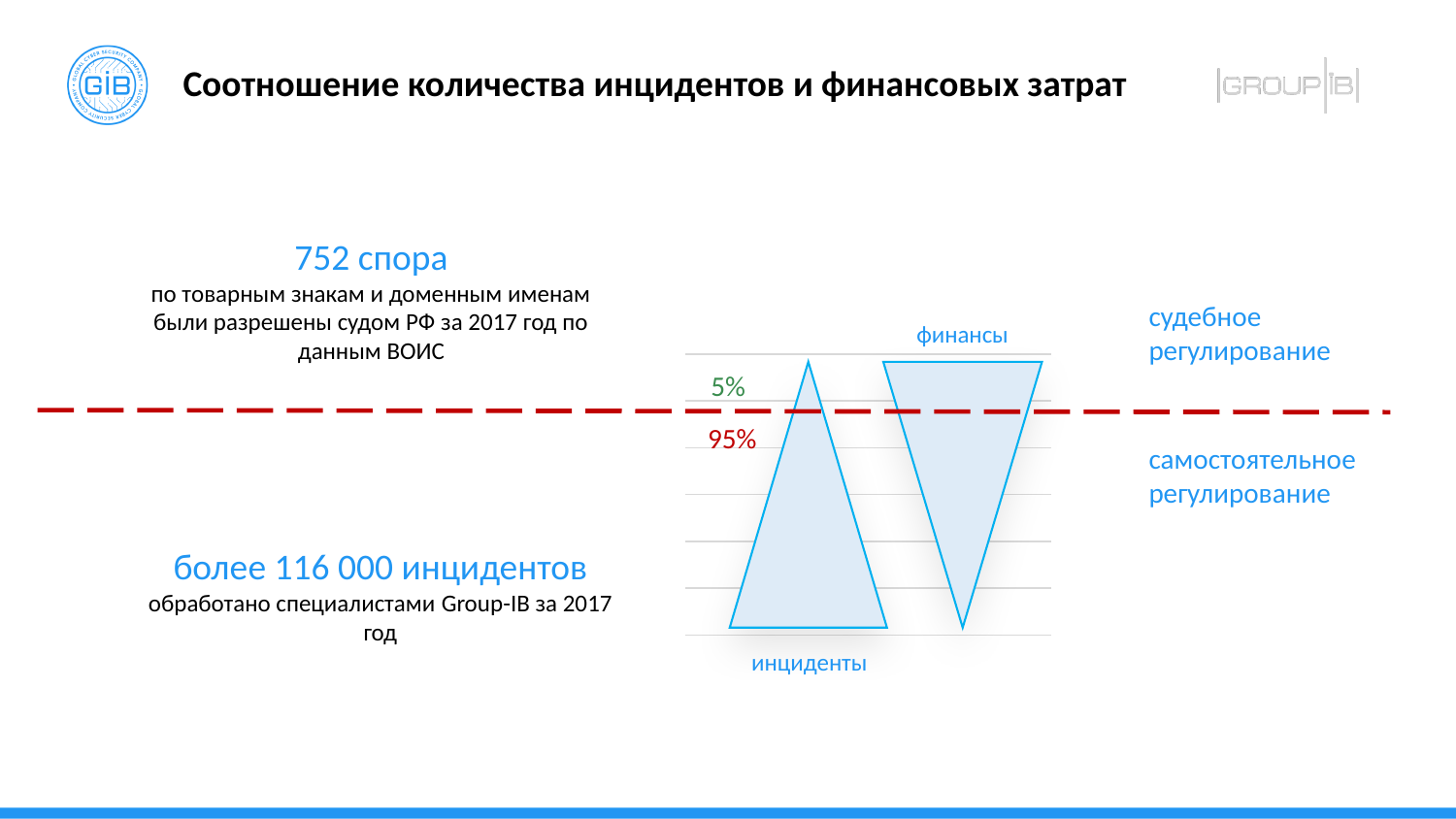
What percentage label is shown below the dashed line, in the 'самостоятельное регулирование' zone? 95% Which of the two labelled shares is larger: the one above the dashed line or the one below it? below (95%) Which shape is widest at the top of the chart, near the 'судебное регулирование' zone? финансы What are the two labelled shapes on the chart called? инциденты and финансы Which shape is widest at the bottom of the chart, in the 'самостоятельное регулирование' zone? инциденты How many triangular shapes are plotted on the chart? 2 Is the share labelled for 'самостоятельное регулирование' greater or less than 50%? greater What is the difference between the two percentage labels shown on the chart? 90% What is the title of the slide containing the chart? Соотношение количества инцидентов и финансовых затрат Is the share labelled for 'судебное регулирование' greater or less than 50%? less What percentage label is shown above the dashed line, in the 'судебное регулирование' zone? 5%